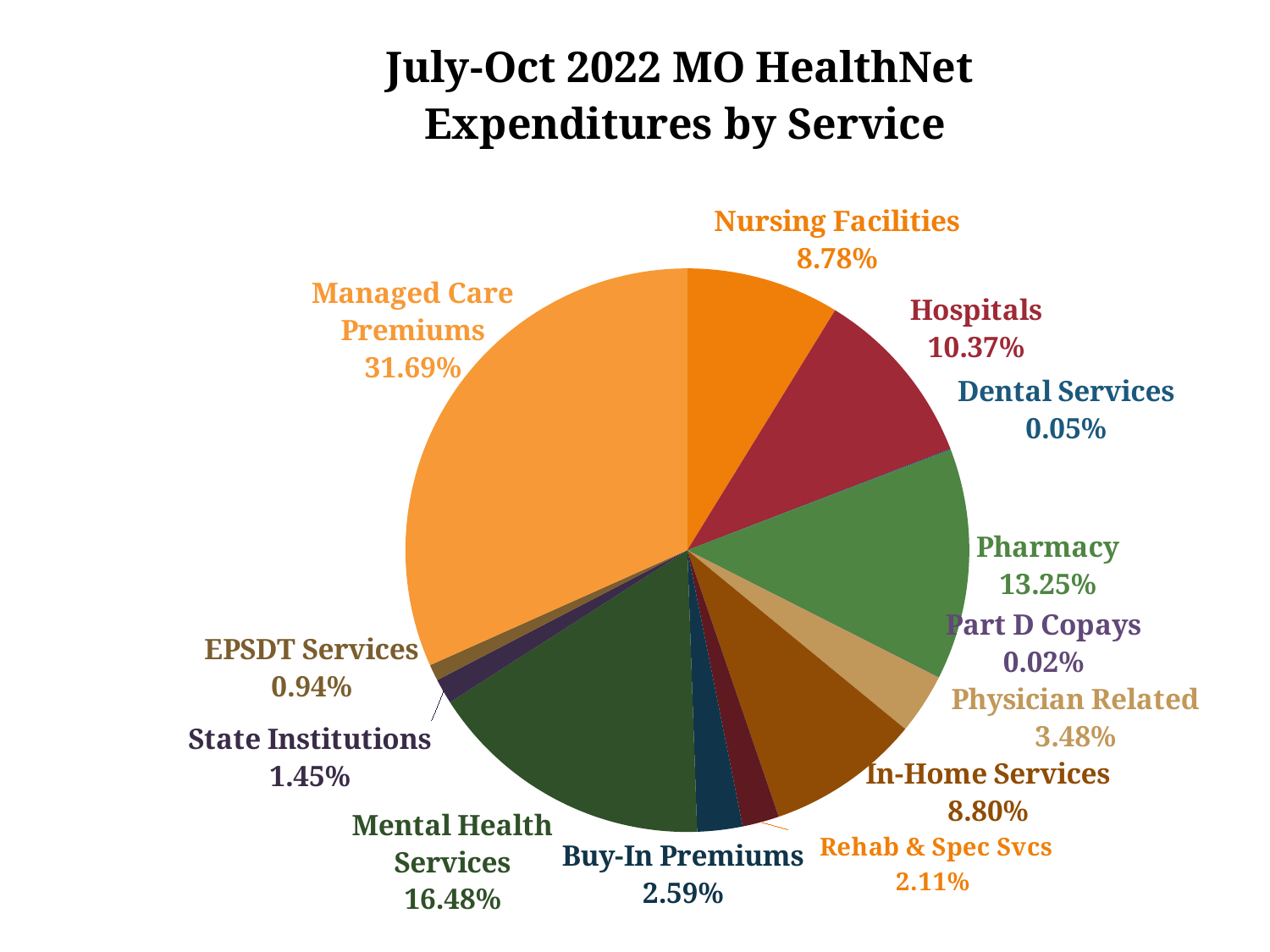
What share of expenditures is Pharmacy? 13.25% What is the title of the chart? July-Oct 2022 MO HealthNet Expenditures by Service Which service category has the largest share of expenditures? Managed Care Premiums Which service category has the smallest share of expenditures? Part D Copays What type of chart is shown on the slide? Pie chart What is the value shown for Rehab & Spec Svcs? 2.11% Which is larger, the share for In-Home Services or the share for Physician Related? In-Home Services What share of expenditures is Mental Health Services? 16.48% What is the combined share of Buy-In Premiums and State Institutions? 4.04% What is the difference in percentage points between Hospitals and Nursing Facilities? 1.59 How many service categories are shown in the pie chart? 13 What share of expenditures is Managed Care Premiums? 31.69%